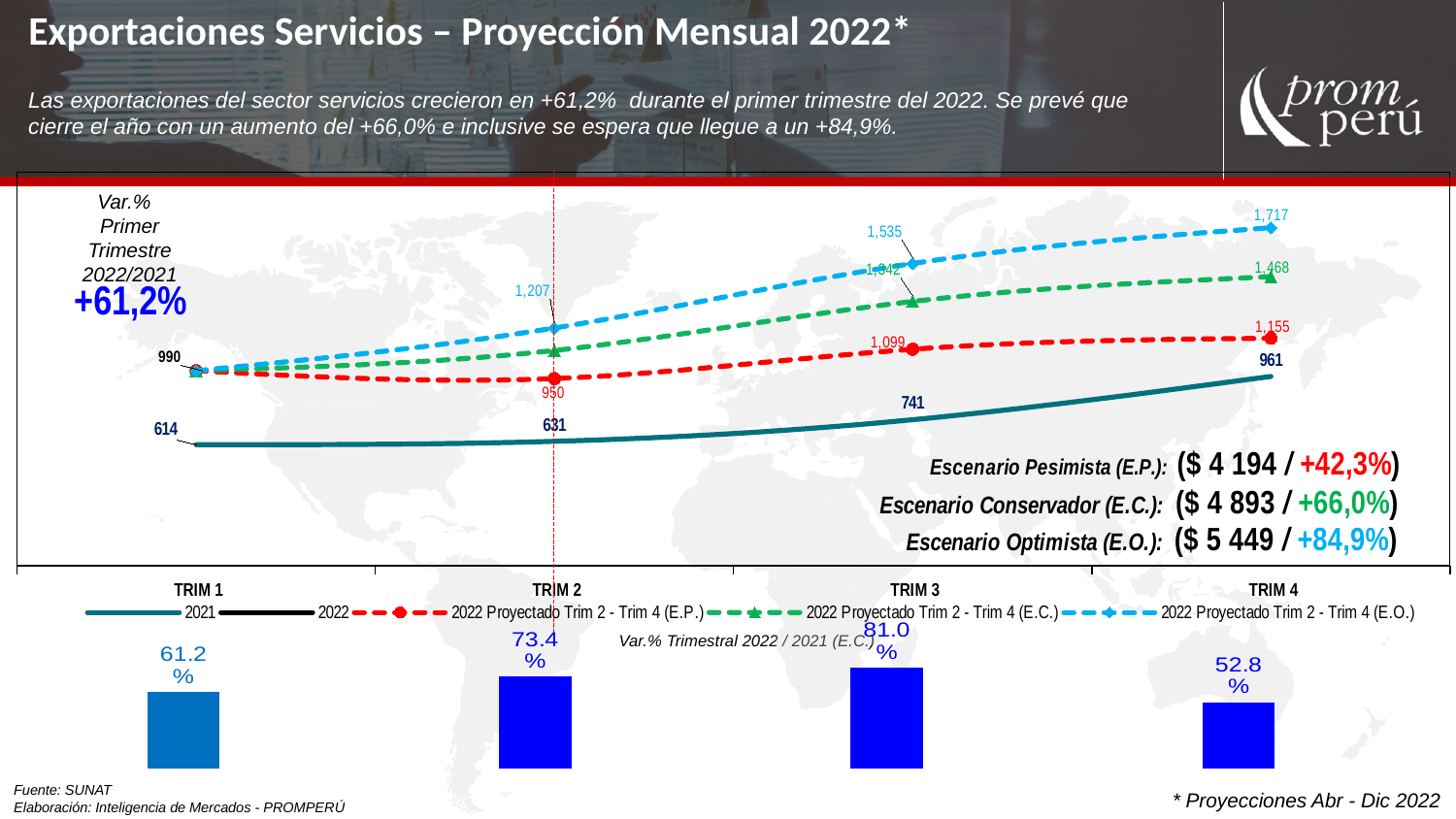
In the bottom bar chart (Var.% Trimestral 2022 / 2021 (E.C.)), how many bars are shown? 4 In the bottom bar chart (Var.% Trimestral 2022 / 2021 (E.C.)), which quarter has the lowest value? TRIM 4 In the top line chart, what is the value of the 2022 Proyectado Trim 2 - Trim 4 (E.O.) series at TRIM 4? 1,717 In the top line chart, does the 2021 series rise or fall from TRIM 1 to TRIM 4? rise In the top line chart, what is the value of the 2021 series at TRIM 4? 961 In the top line chart, what is the value of the 2021 series at TRIM 1? 614 What kind of chart is the bottom chart showing Var.% Trimestral 2022 / 2021 (E.C.)? bar chart In the bottom bar chart (Var.% Trimestral 2022 / 2021 (E.C.)), what is the value for TRIM 2? 73.4% In the bottom bar chart (Var.% Trimestral 2022 / 2021 (E.C.)), which quarter has the highest value? TRIM 3 In the top line chart, how many series does the legend list? 5 In the top line chart, what is the difference between the E.O. and E.P. projected values at TRIM 4? 562 In the top line chart, what is the value of the 2022 Proyectado Trim 2 - Trim 4 (E.P.) series at TRIM 3? 1,099